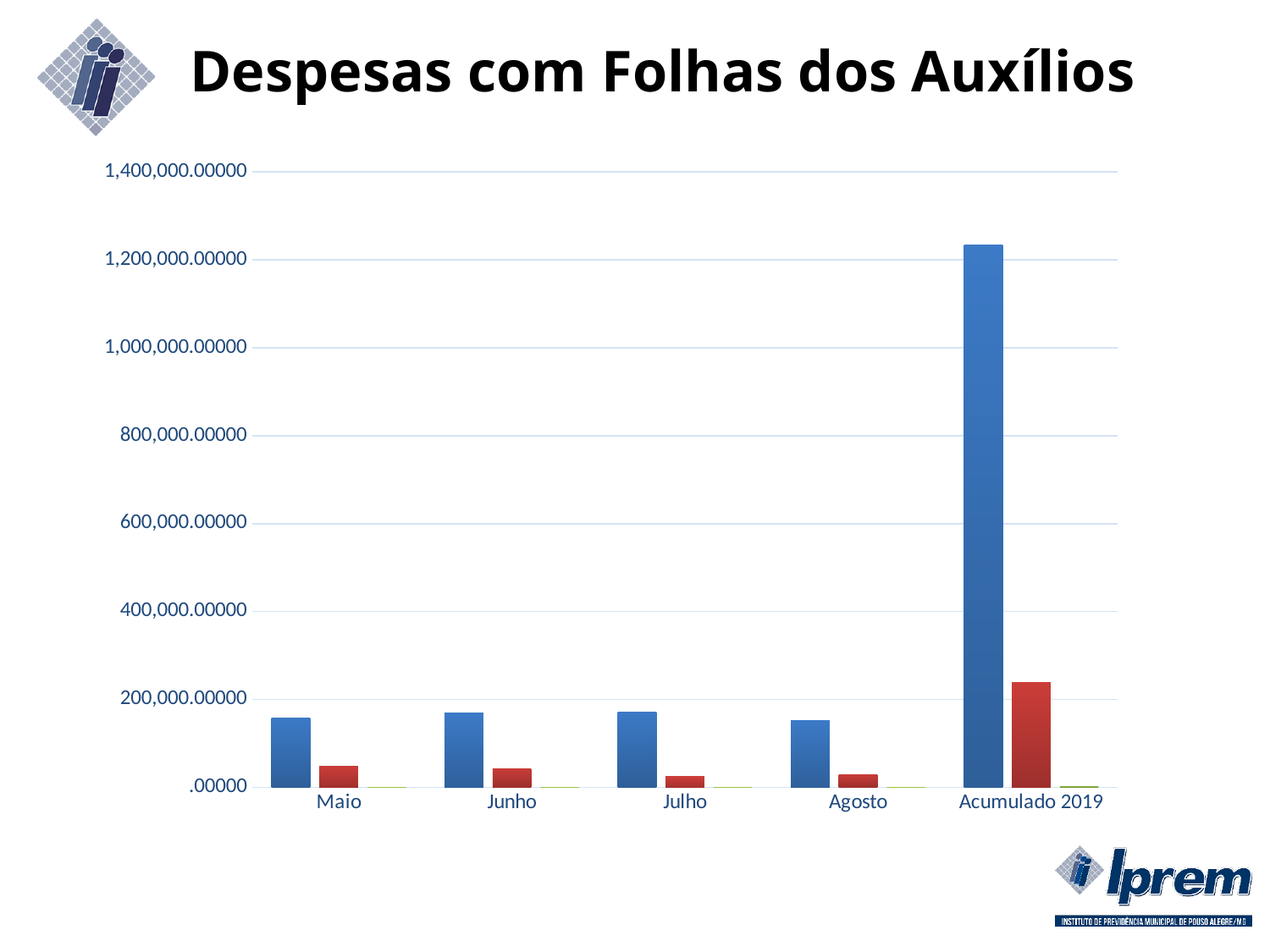
Which category has the tallest bar in the chart? Acumulado 2019 What kind of chart is shown on the slide? bar chart Which is larger, the red bar for Acumulado 2019 or the blue bar for Agosto? the red bar for Acumulado 2019 What is the highest value labelled on the vertical axis of the chart? 1,400,000.00000 Is the value of the blue bar for Maio greater or less than 200,000.00000? less For Maio, which bar is larger, the blue bar or the red bar? the blue bar Is the value of the red bar for Acumulado 2019 greater or less than 200,000.00000? greater Which is larger, the red bar for Maio or the red bar for Julho? the red bar for Maio Is the value of the blue bar for Acumulado 2019 greater or less than 1,000,000.00000? greater How many categories are shown on the x axis of the chart? 5 What is the title of the chart on the slide? Despesas com Folhas dos Auxílios